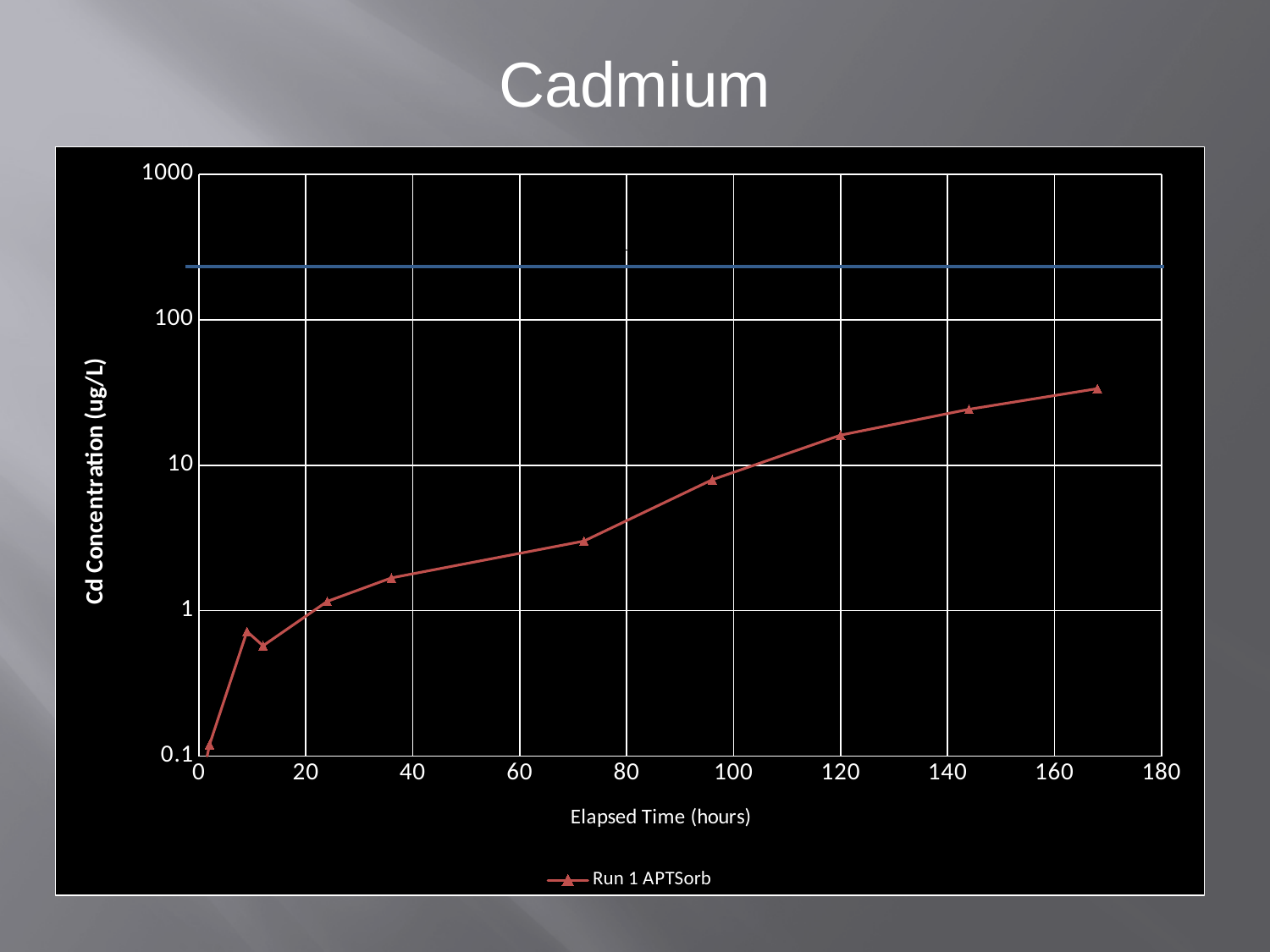
What kind of chart is shown on the slide? line chart Does the Cd concentration for Run 1 APTSorb generally rise or fall as elapsed time increases? rise What is the name of the series in the legend? Run 1 APTSorb Is the Cd concentration for Run 1 APTSorb at about 168 hours greater or less than 10 ug/L? greater Which is larger for Run 1 APTSorb: the Cd concentration at about 144 hours or at about 96 hours? about 144 hours What is the title of the chart? Cadmium How many series does the legend list? 1 Is the Cd concentration for Run 1 APTSorb at about 36 hours greater or less than 1 ug/L? greater How many data points are plotted for Run 1 APTSorb? 10 Is the Cd concentration for Run 1 APTSorb at about 120 hours greater or less than 10 ug/L? greater